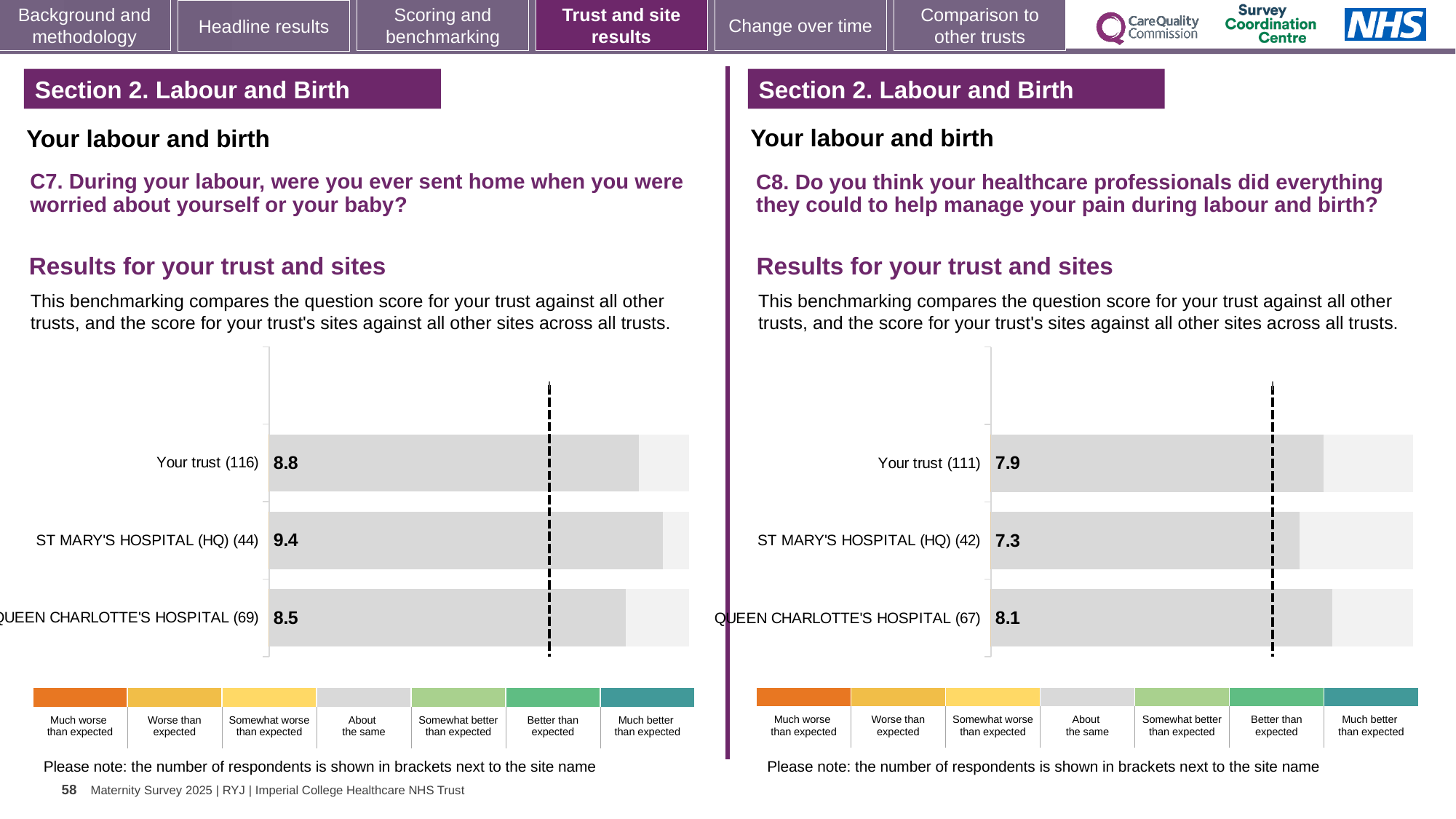
In the C7 chart on the left, what is the score for Your trust? 8.8 In the C7 chart on the left, what is the difference between the scores for ST MARY'S HOSPITAL (HQ) and QUEEN CHARLOTTE'S HOSPITAL? 0.9 In the C8 chart on the right, which site or trust has the lowest score? ST MARY'S HOSPITAL (HQ) In the C7 chart on the left, what is the score for ST MARY'S HOSPITAL (HQ)? 9.4 How many bars are plotted in the C8 chart on the right? 3 In the C7 chart on the left, which site or trust has the highest score? ST MARY'S HOSPITAL (HQ) In the C8 chart on the right, what is the score for Your trust? 7.9 In the C8 chart on the right, which has the larger score, Your trust or QUEEN CHARLOTTE'S HOSPITAL? QUEEN CHARLOTTE'S HOSPITAL In the C7 chart on the left, what is the score for QUEEN CHARLOTTE'S HOSPITAL? 8.5 In the C8 chart on the right, what is the score for ST MARY'S HOSPITAL (HQ)? 7.3 In the C8 chart on the right, what is the score for QUEEN CHARLOTTE'S HOSPITAL? 8.1 What type of chart is the C7 chart on the left? Bar chart